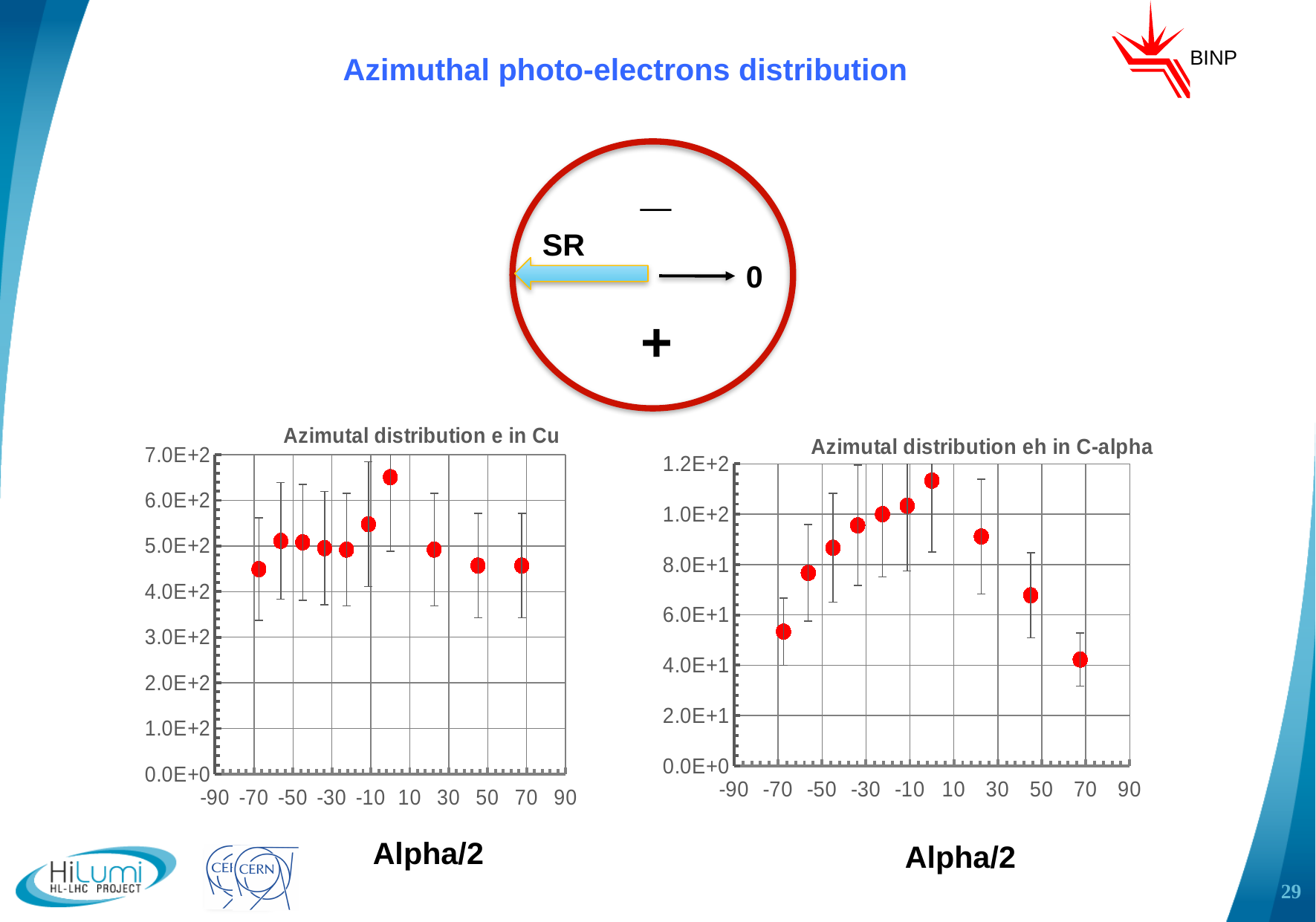
In the 'Azimutal distribution eh in C-alpha' chart, do the values rise or fall as Alpha/2 goes from 0 to 70? fall In the 'Azimutal distribution eh in C-alpha' chart, do the values rise or fall as Alpha/2 goes from -70 to 0? rise In the 'Azimutal distribution e in Cu' chart, is the value of the point near Alpha/2 = 0 greater or less than 6.0E+2? greater What kind of chart is the 'Azimutal distribution e in Cu' chart? scatter chart How many data points are plotted in the 'Azimutal distribution eh in C-alpha' chart? 10 In the 'Azimutal distribution eh in C-alpha' chart, is the value of the point near Alpha/2 = 0 greater or less than 1.0E+2? greater In the 'Azimutal distribution eh in C-alpha' chart, is the value of the rightmost point (near Alpha/2 = 70) greater or less than 6.0E+1? less What is the x-axis label shown under both charts? Alpha/2 In the 'Azimutal distribution eh in C-alpha' chart, which point has the lowest value: the leftmost point or the rightmost point? the rightmost point How many data points are plotted in the 'Azimutal distribution e in Cu' chart? 10